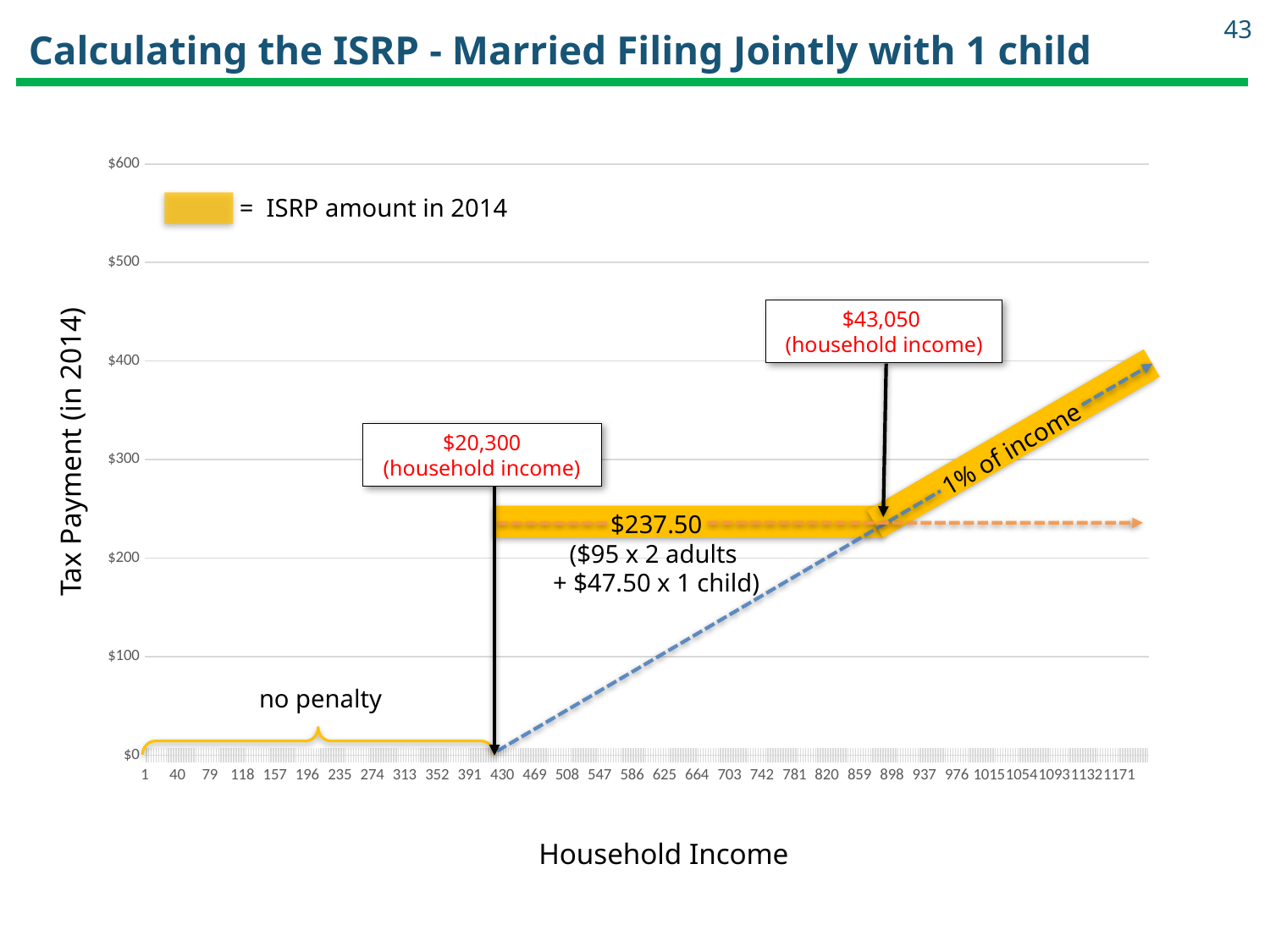
What does the yellow legend swatch represent? ISRP amount in 2014 Is the flat ISRP amount of $237.50 greater or less than $300 on the y axis? less Is the flat ISRP amount of $237.50 greater or less than $200 on the y axis? greater What does the chart label the region of household income below $20,300? no penalty What is the flat ISRP amount shown on the chart for household incomes between $20,300 and $43,050? $237.50 What is the per-adult amount used to compute the $237.50 flat penalty? $95 Does the ISRP amount rise or fall as household income increases beyond $43,050? rise What kind of chart is shown on the slide? line chart At what household income does the ISRP switch from the flat amount to 1% of income? $43,050 What is the label of the y axis? Tax Payment (in 2014) What is the per-child amount used to compute the $237.50 flat penalty? $47.50 At what household income does the ISRP penalty begin, according to the chart? $20,300